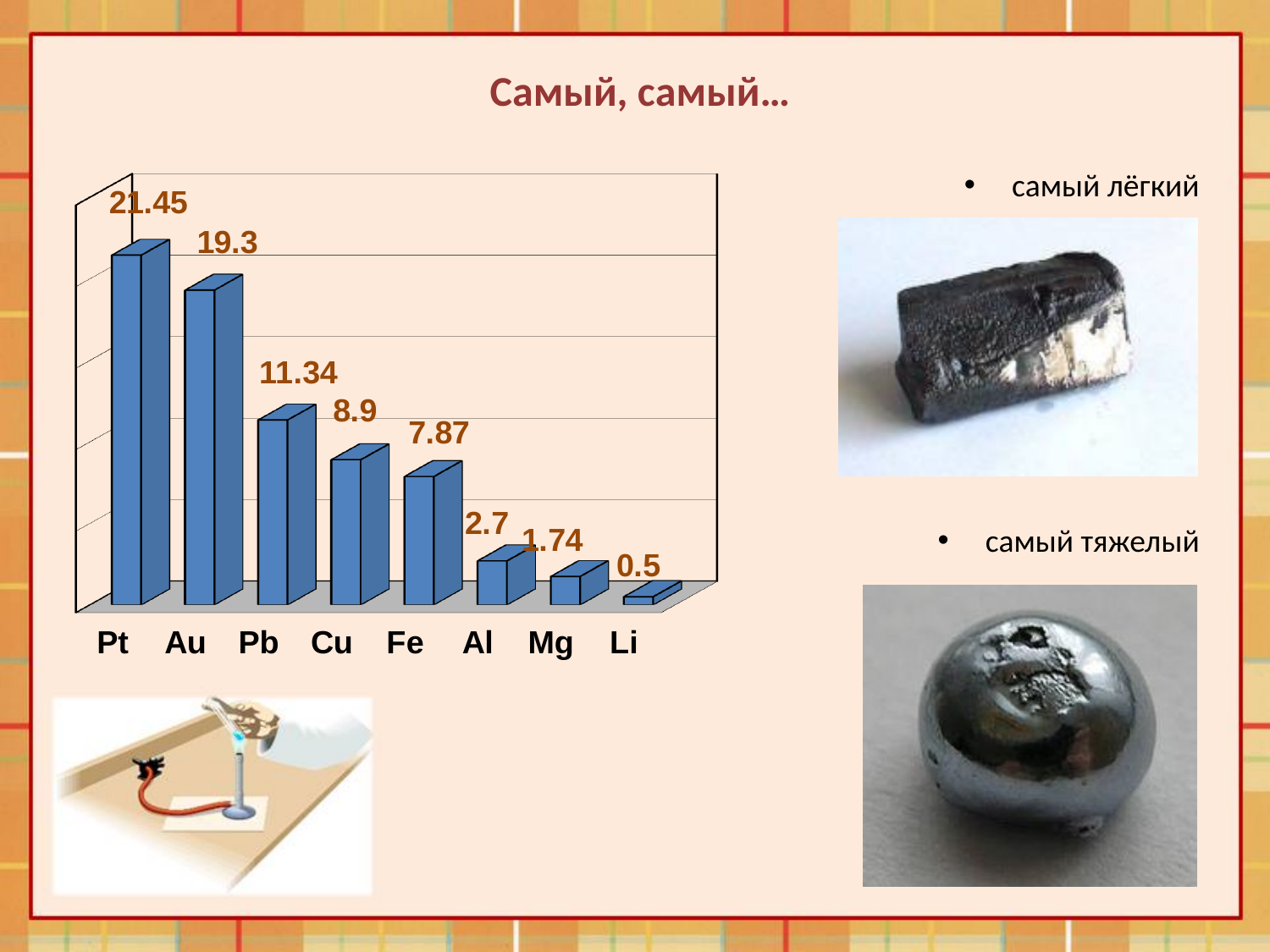
What is the value for Au? 19.3 What is the value for Fe? 7.87 What is the value for Pt? 21.45 Which is larger, the value for Cu or the value for Fe? Cu What kind of chart is shown on the slide? bar chart What is the difference between the values for Pt and Au? 2.15 Do the values rise or fall from left to right along the x axis? fall Which category has the highest value? Pt What is the value for Li? 0.5 Which category has the lowest value? Li How many categories are shown on the x axis? 8 What is the value for Pb? 11.34